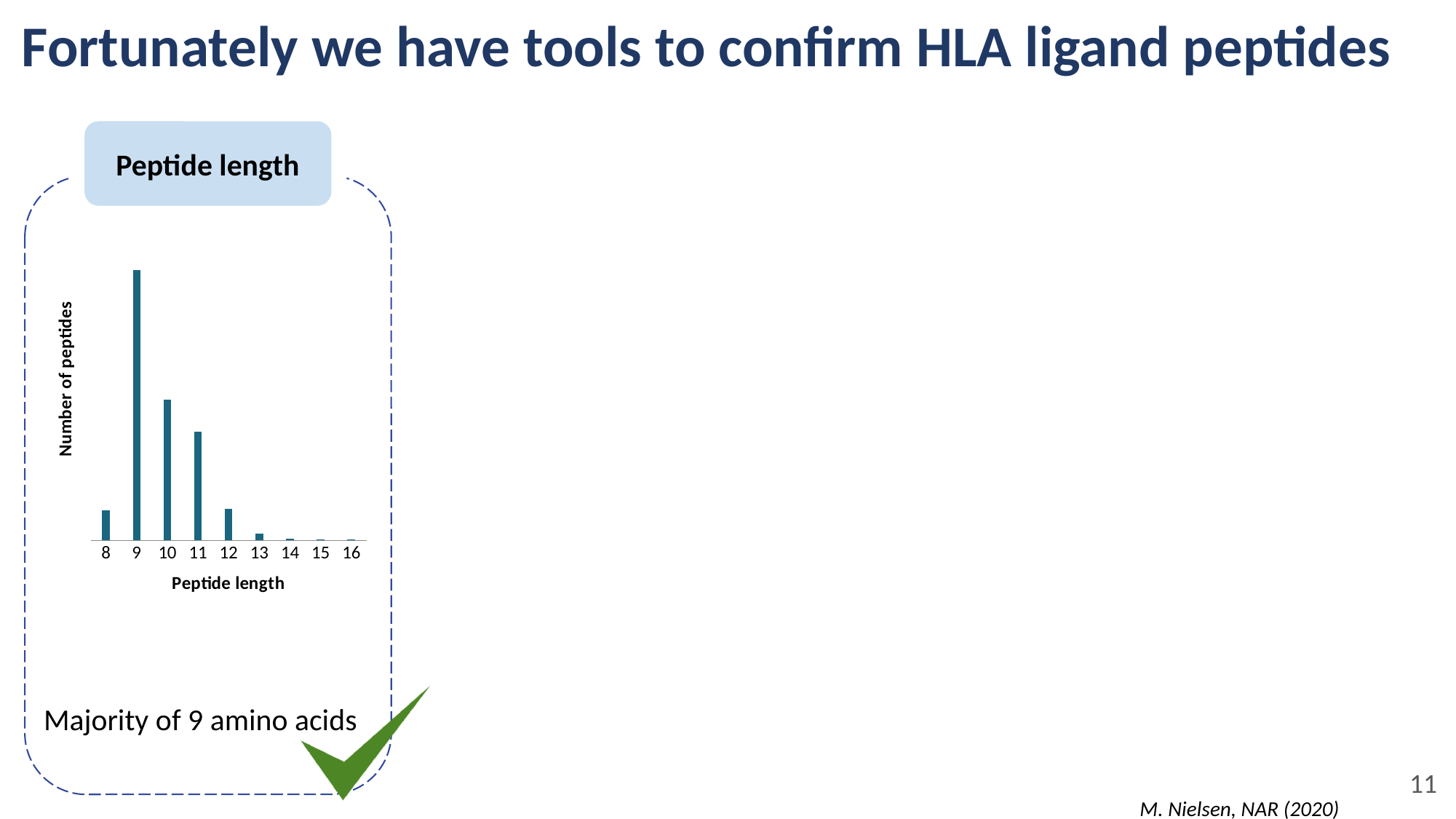
Which has more peptides, length 13 or length 14? 13 Which peptide length has the highest number of peptides? 9 What kind of chart is shown on the slide? bar chart Which has more peptides, length 10 or length 11? 10 Which has more peptides, length 11 or length 12? 11 What is the label of the x axis? Peptide length What is the label of the y axis? Number of peptides Do the values rise or fall as peptide length increases from 9 to 16? fall How many peptide length categories are shown on the x axis? 9